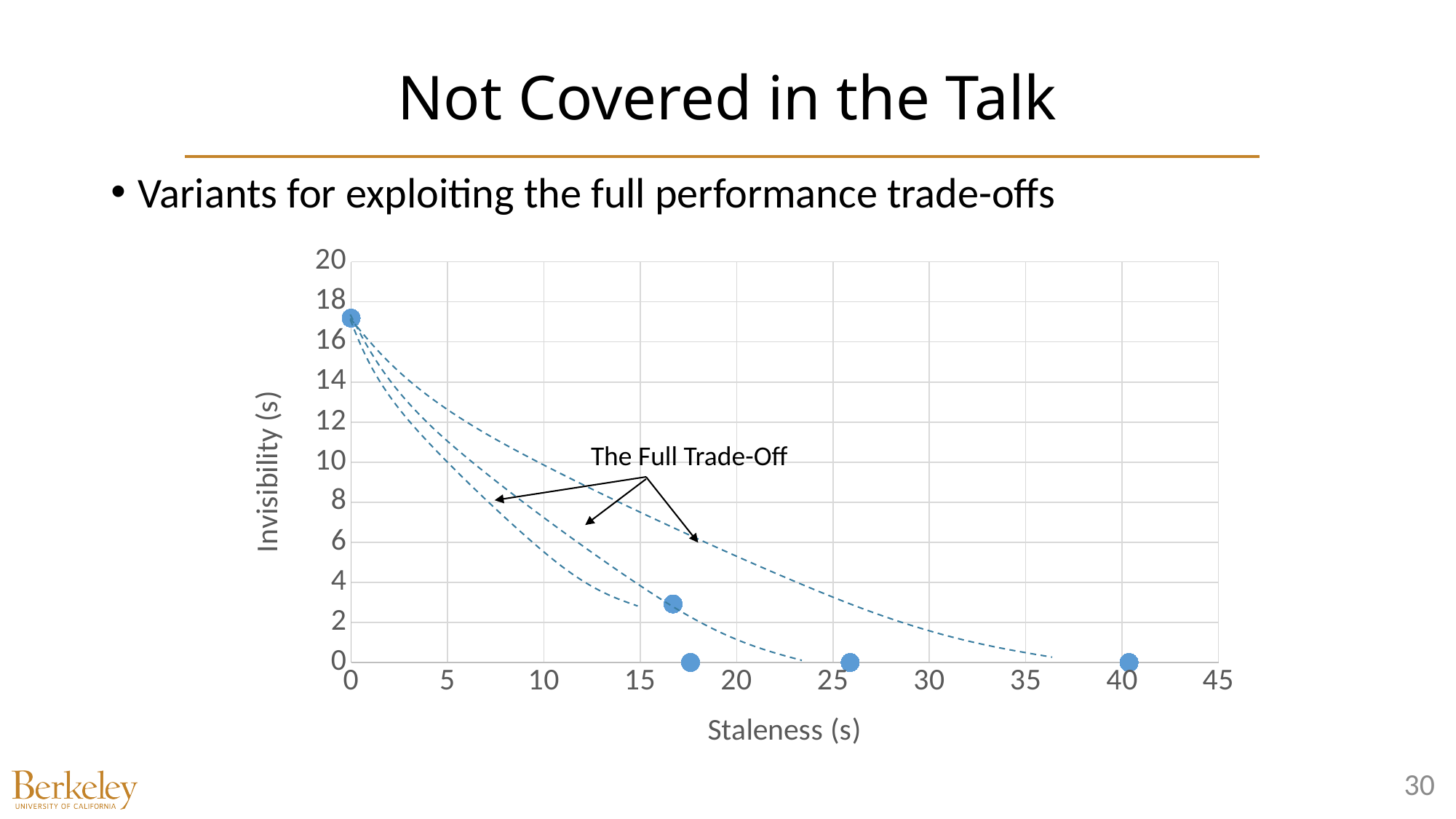
What kind of chart is shown on the slide? Scatter chart How many data points are plotted on the chart? 5 Is the invisibility of the point near staleness 17 that lies above the x axis greater or less than 5? less What is the maximum value shown on the y axis? 20 Do the dashed trade-off curves rise or fall as staleness increases? Fall Is the invisibility of the point at staleness about 26 greater or less than 2? less Which point has the highest invisibility: the one at staleness 0 or the one at staleness about 40? The one at staleness 0 What is the label of the y axis? Invisibility (s) What is the label of the x axis? Staleness (s) Is the staleness of the rightmost point greater or less than 35? greater